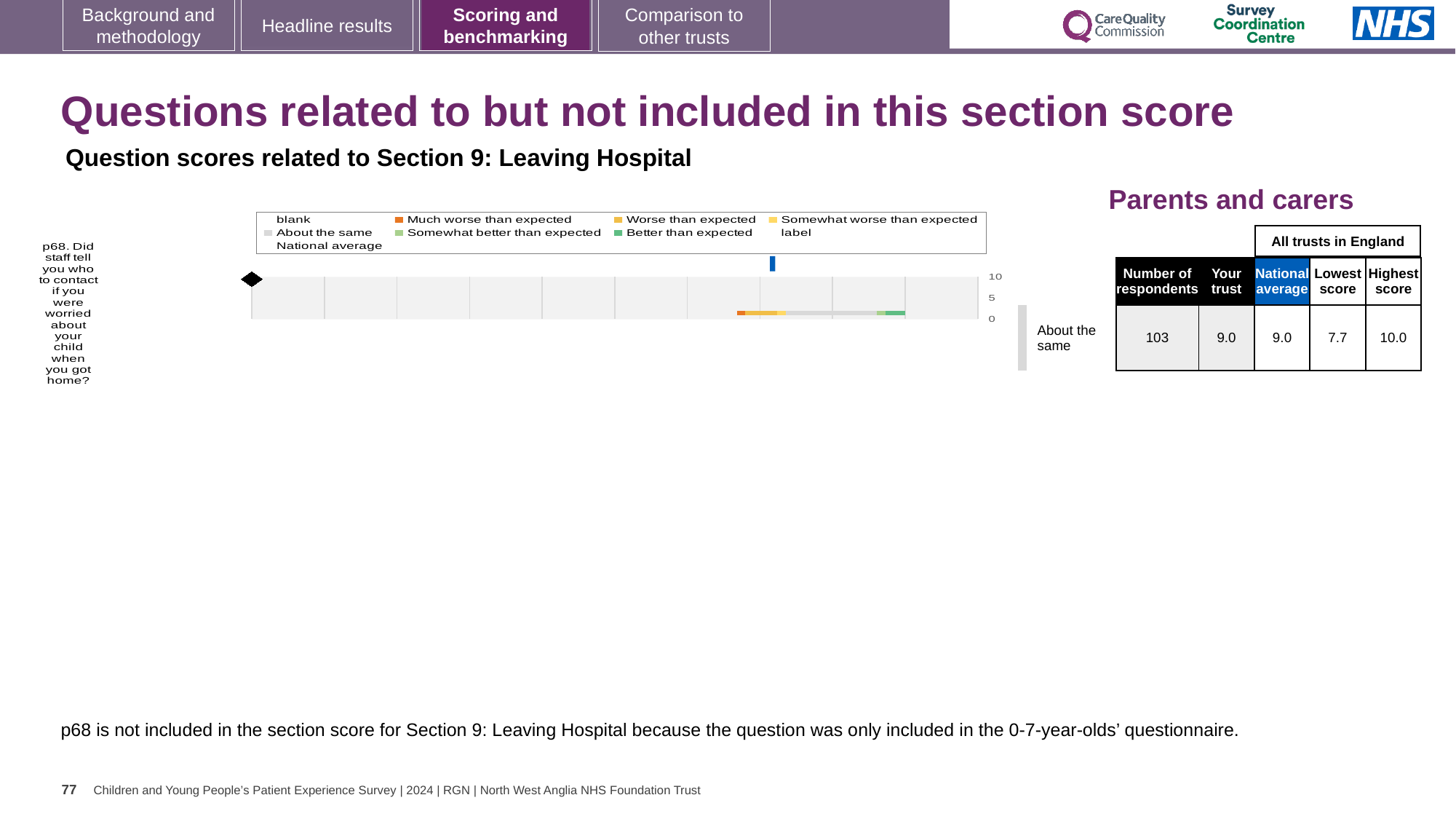
What is the national average score for p68 shown in the table next to the chart? 9.0 Is the trust's score for p68 larger than, smaller than, or equal to the national average? equal How many survey questions are plotted in the chart? 1 What is the lowest score among all trusts in England for p68? 7.7 What kind of chart is used to show the p68 question score? bar chart What is the highest value shown on the chart's score axis? 10 What is the difference between the highest and lowest trust scores for p68? 2.3 Which question is plotted in the chart? p68. Did staff tell you who to contact if you were worried about your child when you got home? What is the trust's score for p68 shown in the table next to the chart? 9.0 How many respondents answered p68? 103 What is the highest score among all trusts in England for p68? 10.0 What benchmark category is the trust's p68 score placed in, as labelled beside the chart? About the same